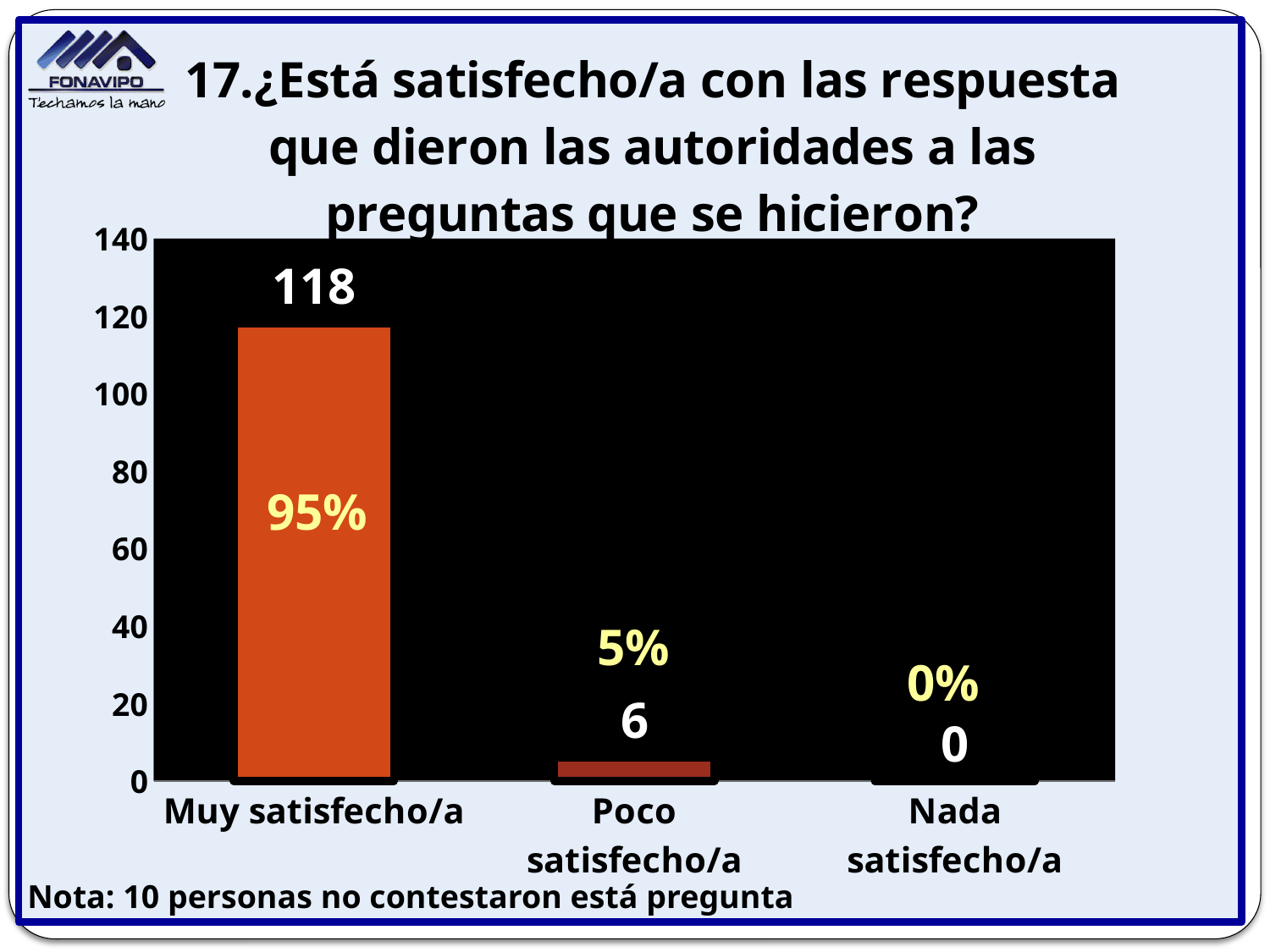
Which is larger, the value for Poco satisfecho/a or the value for Nada satisfecho/a? Poco satisfecho/a What percentage is shown for Poco satisfecho/a? 5% What is the value for Poco satisfecho/a? 6 Which category has the highest value? Muy satisfecho/a What percentage is shown for Muy satisfecho/a? 95% How many categories are shown on the x axis? 3 What kind of chart is shown on the slide? Bar chart What is the value for Nada satisfecho/a? 0 What is the value for Muy satisfecho/a? 118 What is the difference between the values for Muy satisfecho/a and Poco satisfecho/a? 112 According to the note on the slide, how many people did not answer this question? 10 Which category has the lowest value? Nada satisfecho/a